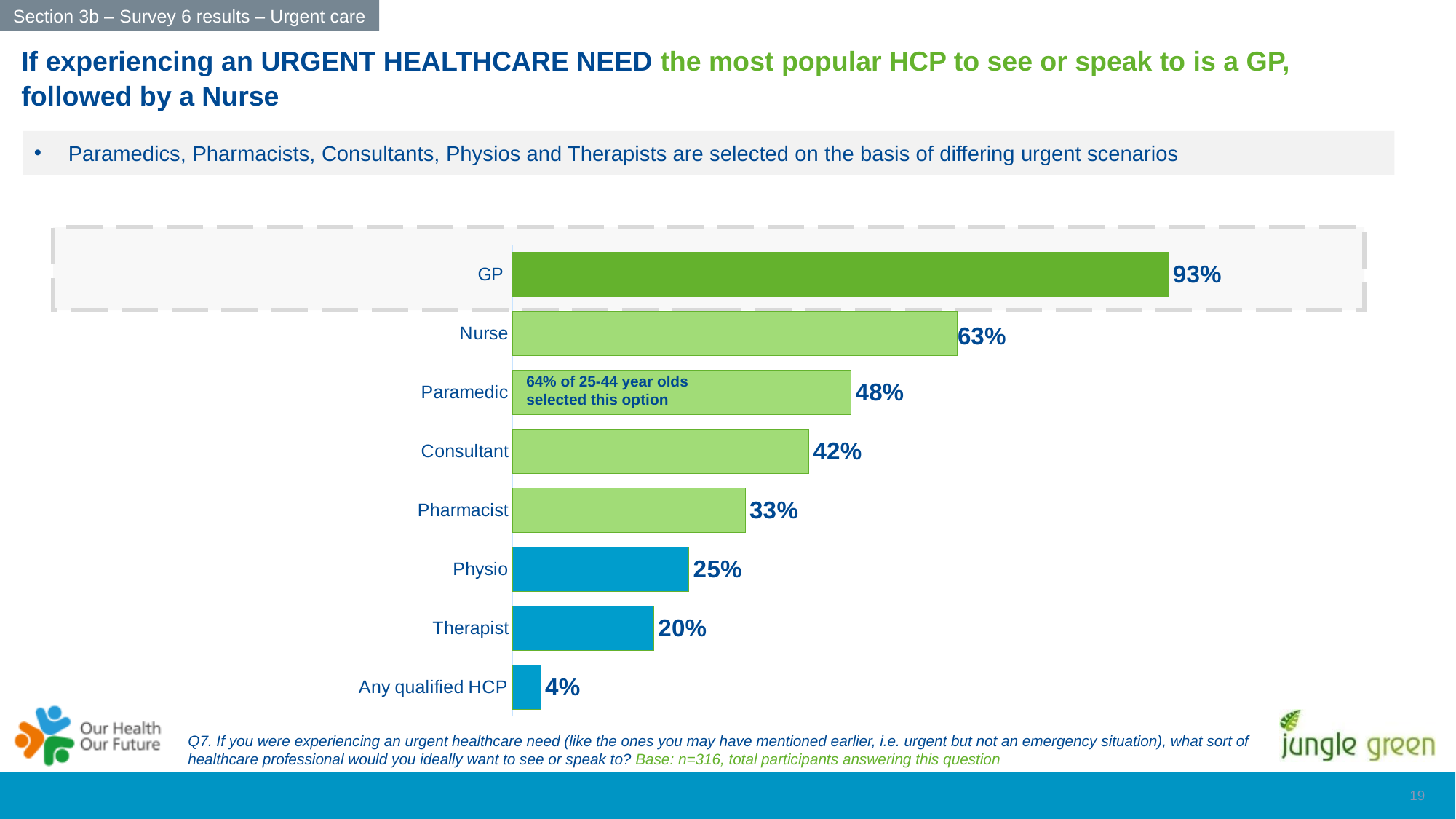
What type of chart is used on this slide? Bar chart According to the annotation on the Paramedic bar, what percentage of 25-44 year olds selected this option? 64% What is the value shown for Nurse? 63% Which has a higher value, Physio or Therapist? Physio What is the value for Any qualified HCP? 4% What is the difference in percentage points between Paramedic and Consultant? 6 How many healthcare professional categories are shown in the chart? 8 What is the difference in percentage points between GP and Nurse? 30 Which healthcare professional has the highest percentage in the chart? GP What percentage of participants selected GP as the healthcare professional they would want to see or speak to for an urgent healthcare need? 93% Which category has the lowest percentage in the chart? Any qualified HCP What percentage is shown for Pharmacist? 33%